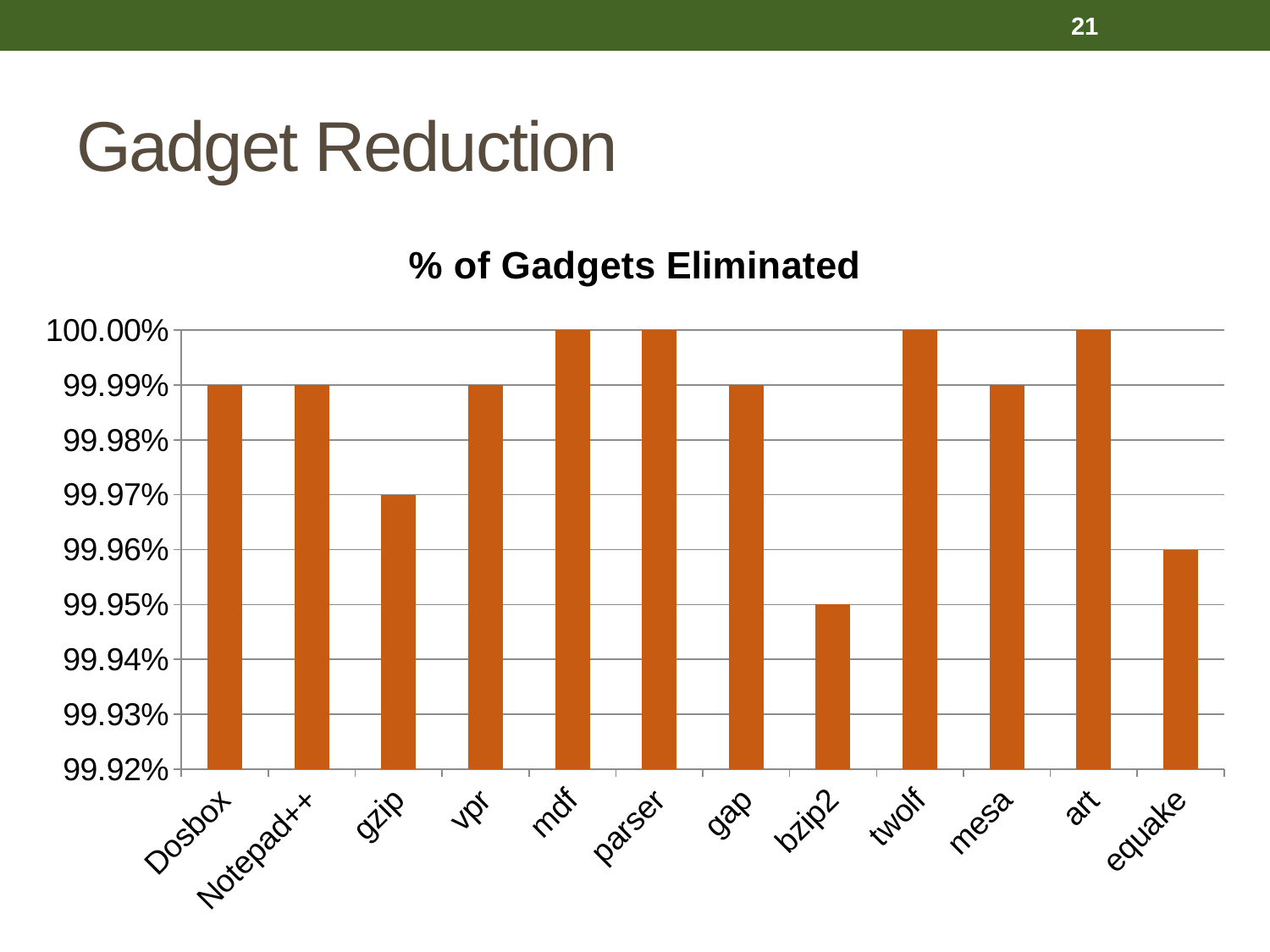
What is the value for equake? 99.96% What is the value for gzip? 99.97% Which category has the lowest % of gadgets eliminated? bzip2 What is the value for Dosbox? 99.99% What is the value for mdf? 100.00% How many categories are plotted on the x axis? 12 Is the value for bzip2 greater or less than 99.96%? less What is the chart title? % of Gadgets Eliminated What is the difference between the value for art and the value for equake? 0.04% Which is larger, the value for gzip or the value for bzip2? gzip What type of chart is shown on the slide? bar chart What is the value for bzip2? 99.95%